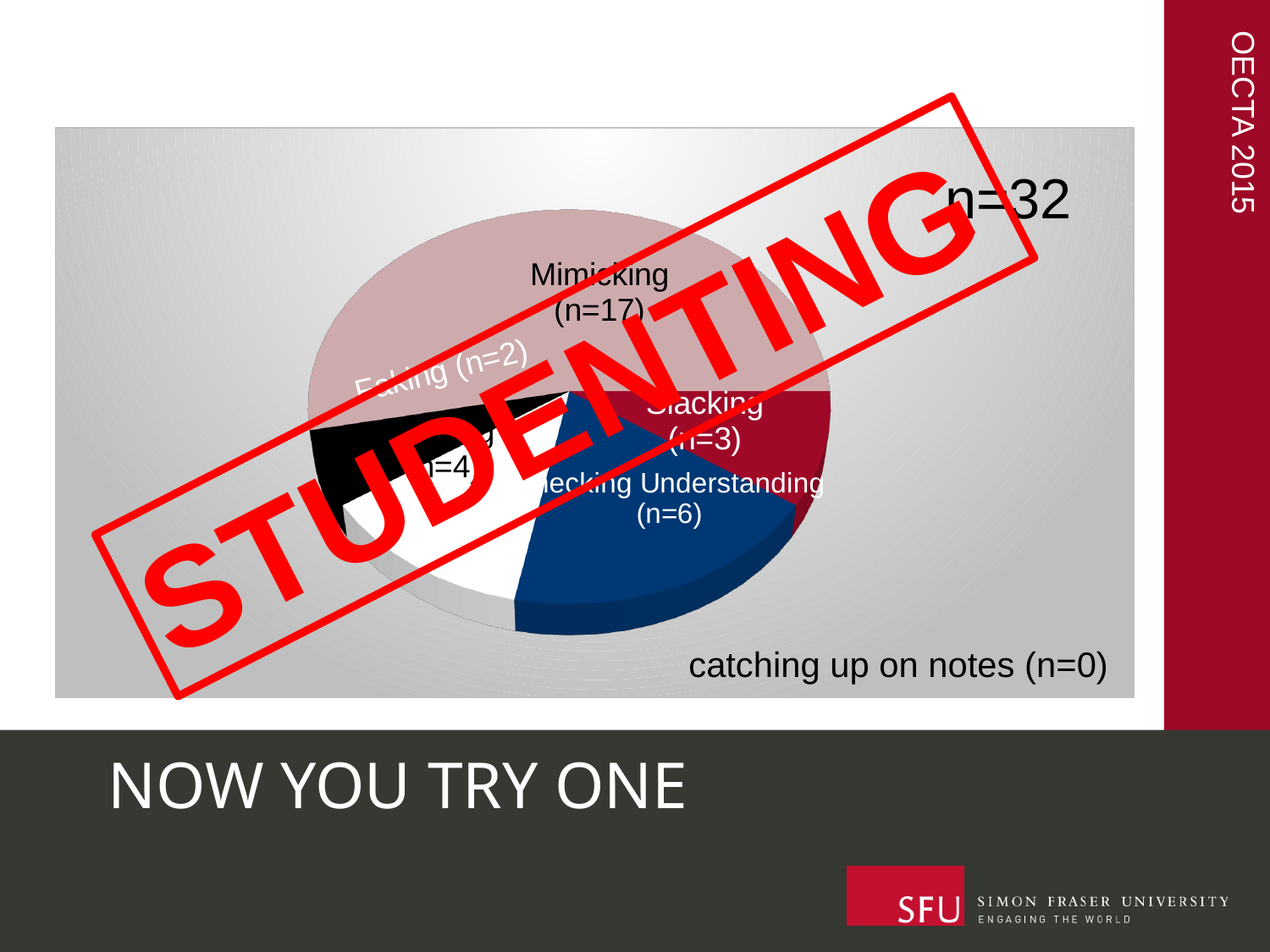
Which has a larger n value, Mimicking or Checking Understanding? Mimicking What is the n value for Slacking in the pie chart? 3 Which category has the largest n value in the pie chart? Mimicking Which category has the smallest n value in the pie chart? catching up on notes What is the n value for Checking Understanding in the pie chart? 6 What word is stamped in red across the pie chart? STUDENTING What is the n value for catching up on notes in the pie chart? 0 What is the total n shown for the pie chart? n=32 What is the n value for Mimicking in the pie chart? 17 What is the difference between the n values for Mimicking and Checking Understanding? 11 What kind of chart is shown on the slide? pie chart How many category labels are shown on the pie chart? 6